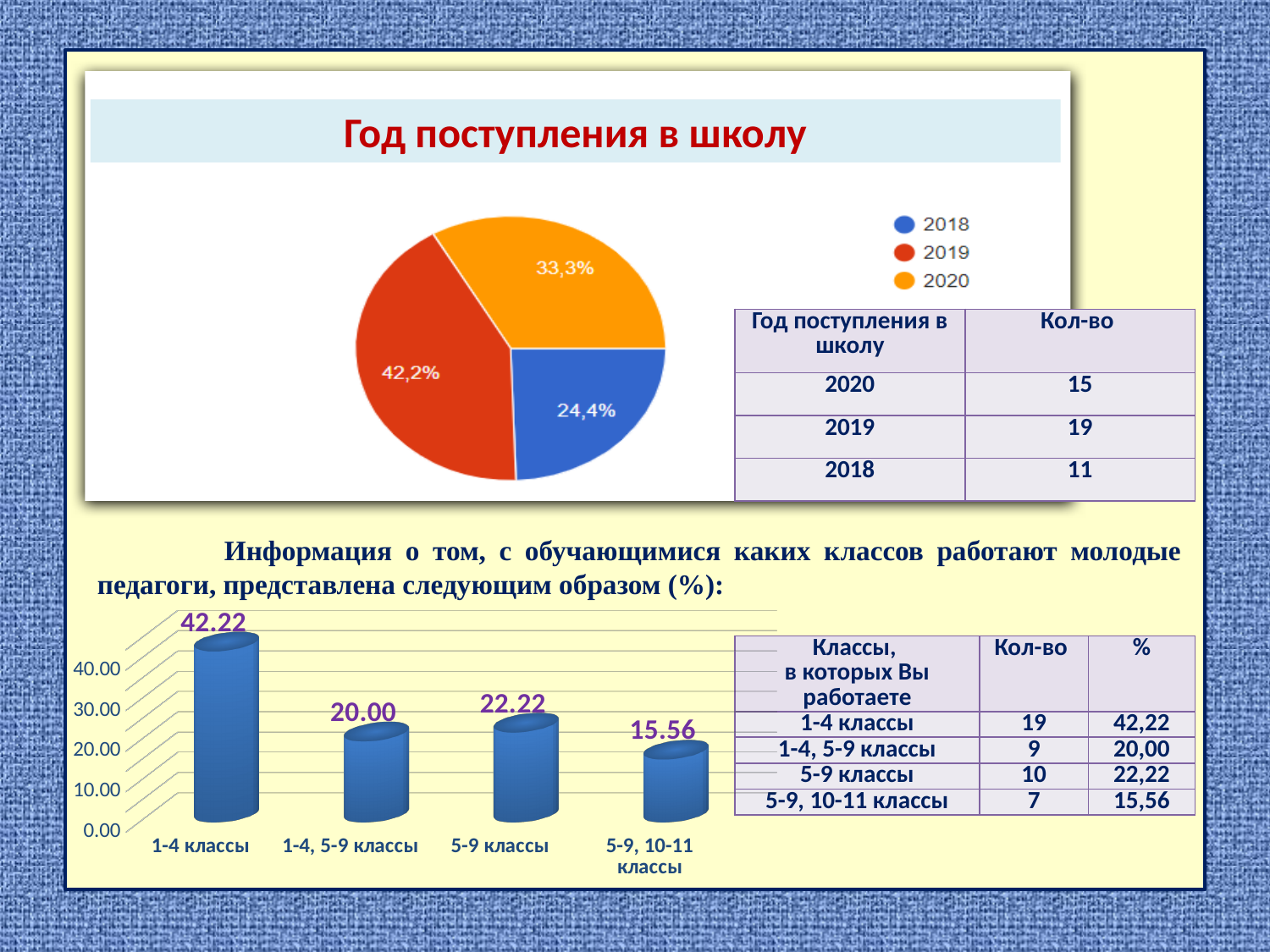
In the pie chart titled "Год поступления в школу", what share does the 2019 slice have? 42,2% In the bar chart at the bottom of the slide, what is the difference between the values for "1-4 классы" and "5-9 классы"? 20.00 In the pie chart titled "Год поступления в школу", which year has the largest slice? 2019 In the pie chart titled "Год поступления в школу", what share does the 2018 slice have? 24,4% In the pie chart titled "Год поступления в школу", which year has the smallest slice? 2018 What kind of chart is the chart at the bottom of the slide showing classes? Bar chart In the bar chart at the bottom of the slide, which category has the lowest value? 5-9, 10-11 классы In the bar chart at the bottom of the slide, what is the value for "1-4 классы"? 42.22 In the pie chart titled "Год поступления в школу", how many entries does the legend list? 3 In the bar chart at the bottom of the slide, how many categories are shown on the x axis? 4 In the pie chart titled "Год поступления в школу", what colour is the 2020 slice? Orange In the bar chart at the bottom of the slide, what is the value for "5-9, 10-11 классы"? 15.56